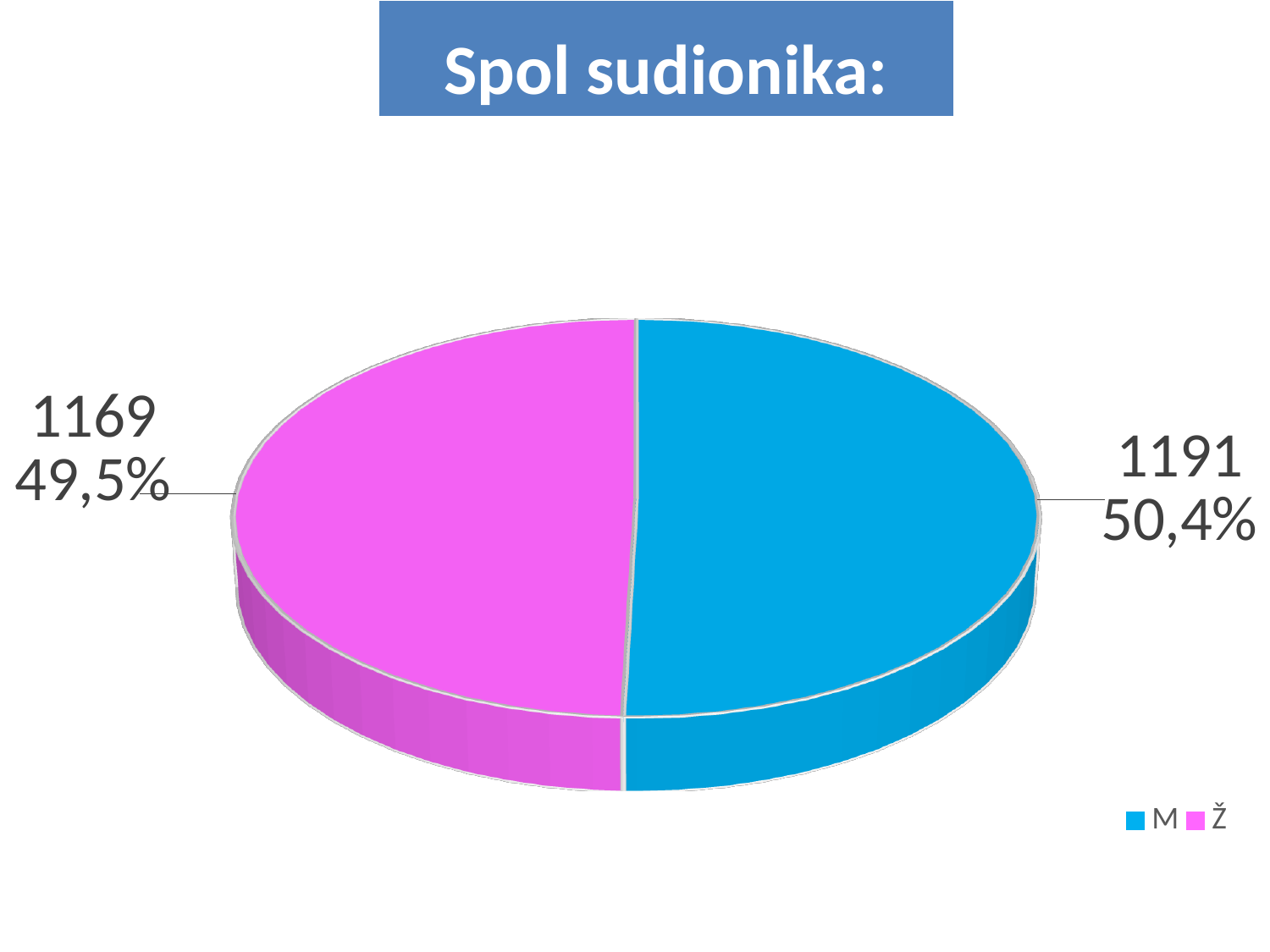
How many slices does the pie chart have? 2 What is the value for M? 1191 What is the difference between the values for M and Ž? 22 What is the title of the chart? Spol sudionika: What is the value for Ž? 1169 Which category has the highest value? M Which is larger, the value for M or the value for Ž? M What kind of chart is shown on the slide? pie chart What share of the pie does the M slice represent? 50,4% Which category has the lowest value? Ž What share of the pie does the Ž slice represent? 49,5% What colour is the Ž slice? magenta